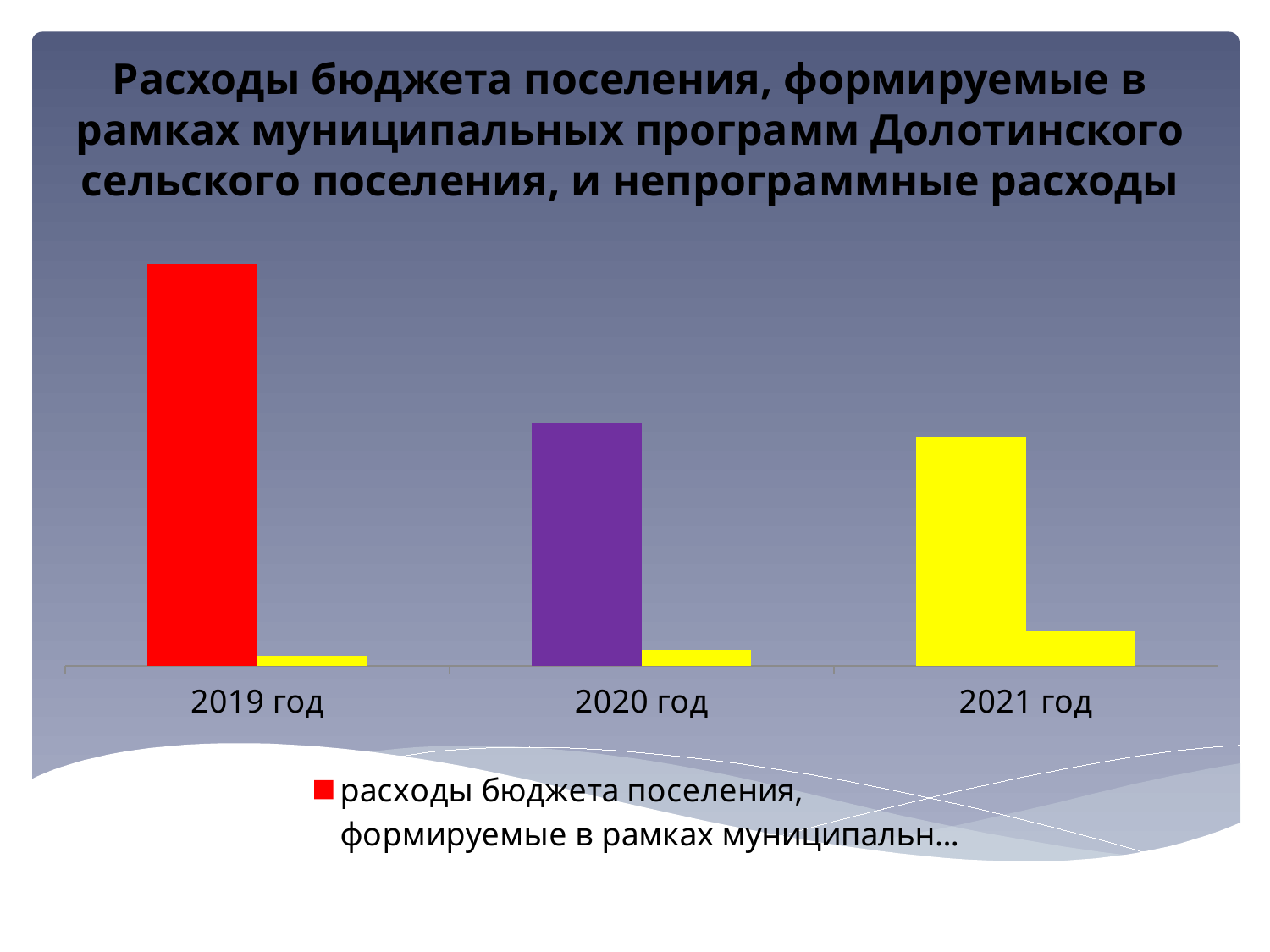
What colour is the left bar for 2020 год? purple What kind of chart is shown on the slide? bar chart Do the values of the first (left) series rise or fall from 2019 год to 2021 год? fall Is the left bar for 2019 год taller or shorter than the left bar for 2020 год? taller Which year has the largest bar for the second (right, small yellow) series? 2021 год Is the small right-hand bar for 2021 год larger or smaller than the small right-hand bar for 2019 год? larger What colour is the left bar for 2019 год? red How many year categories are shown on the x axis? 3 Which year has the smallest bar for the second (right, small yellow) series? 2019 год Do the values of the second (right, small yellow) series rise or fall from 2019 год to 2021 год? rise Which year has the tallest bar for the first (left) series? 2019 год